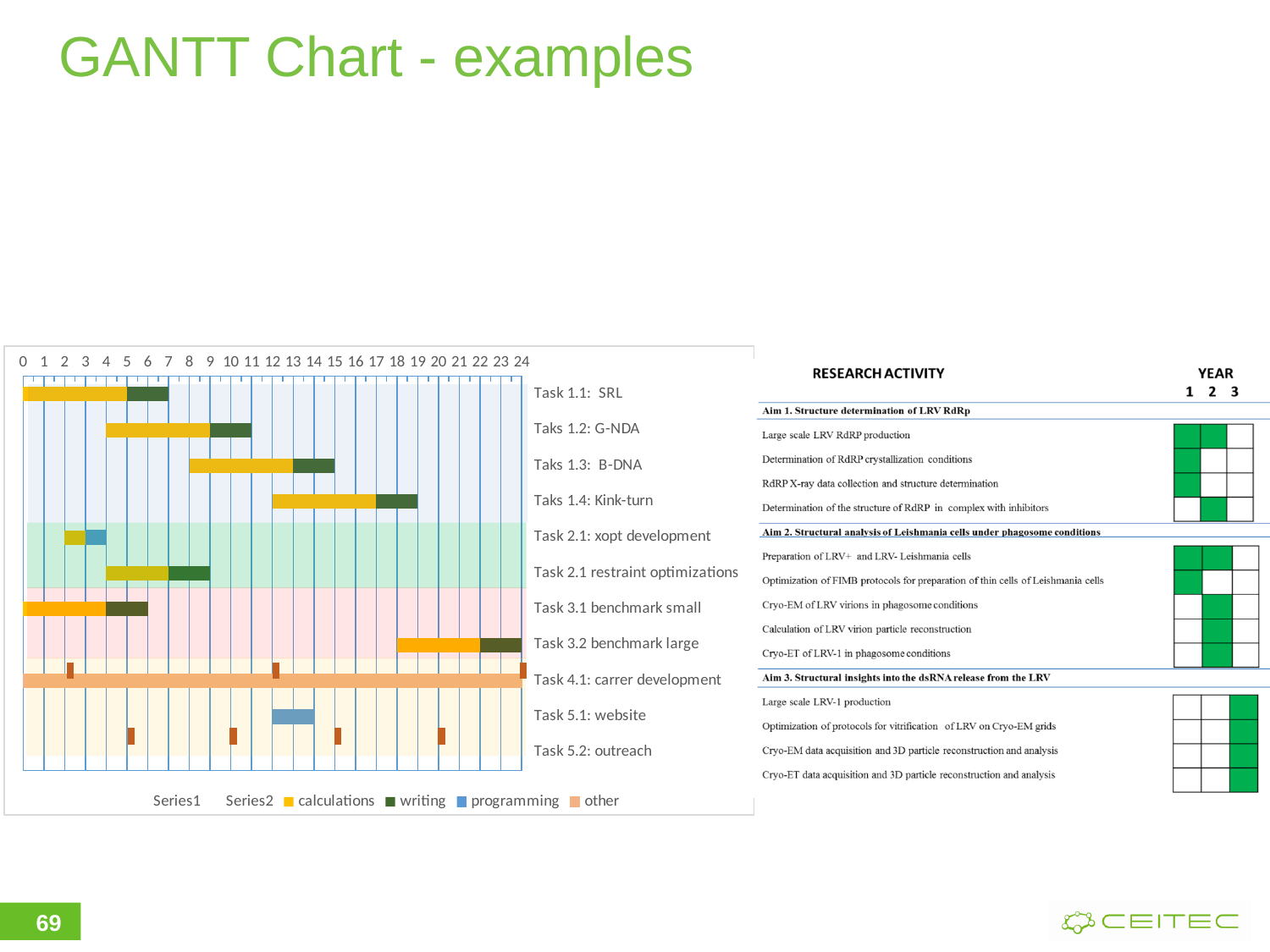
In the left chart, does the bar for Task 3.2 benchmark large start before or after 15 on the horizontal axis? after In the left chart, what is the highest value shown on the horizontal axis? 24 In the left chart, which legend entry is shown in yellow? calculations In the left chart, how many entries does the legend list? 6 In the left chart, how many tasks are listed along the vertical axis? 11 In the left chart, which task has a bar spanning the entire axis from 0 to 24? Task 4.1: carrer development In the right-hand table, how many years does the YEAR header cover? 3 What kind of chart is shown on the left side of the slide? bar chart In the left chart, which legend entry is shown in dark green? writing In the right-hand table, how many research activities are listed under Aim 2? 5 In the left chart, which task's bar is longer: Task 2.1: xopt development or Task 1.3: B-DNA? Task 1.3: B-DNA In the left chart, does the bar for Task 1.1: SRL end before or after 10 on the horizontal axis? before